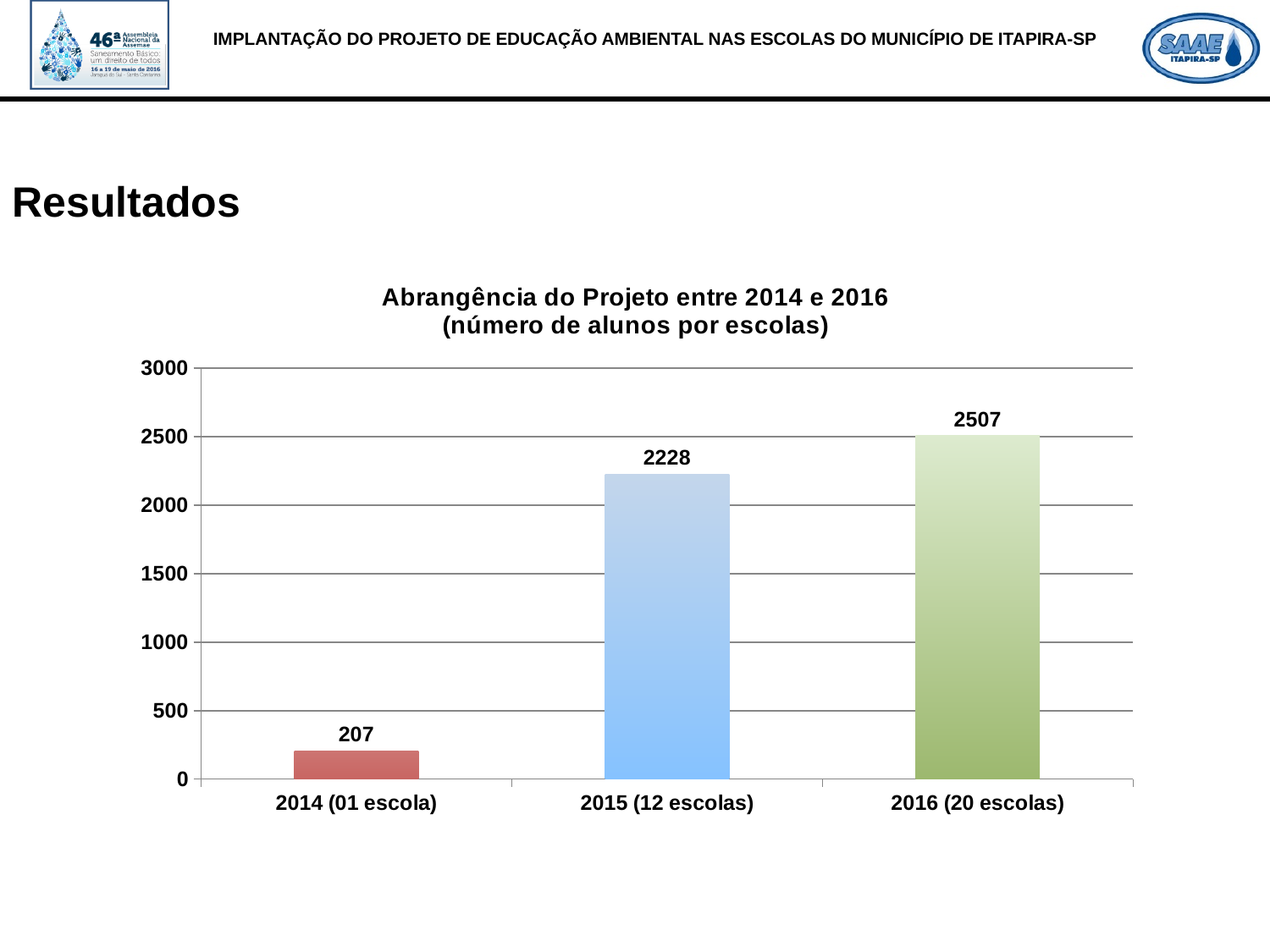
How many categories are shown on the x axis? 3 What is the value for 2015 (12 escolas)? 2228 Do the values rise or fall from 2014 to 2016? rise What is the value for 2016 (20 escolas)? 2507 Which category has the lowest value? 2014 (01 escola) Which category has the highest value? 2016 (20 escolas) What is the difference between the values for 2016 (20 escolas) and 2015 (12 escolas)? 279 Which is larger, the value for 2015 (12 escolas) or the value for 2014 (01 escola)? 2015 (12 escolas) Is the value for 2016 (20 escolas) greater or less than 2500? greater What is the value for 2014 (01 escola)? 207 What kind of chart is shown on the slide? bar chart What is the difference between the values for 2015 (12 escolas) and 2014 (01 escola)? 2021